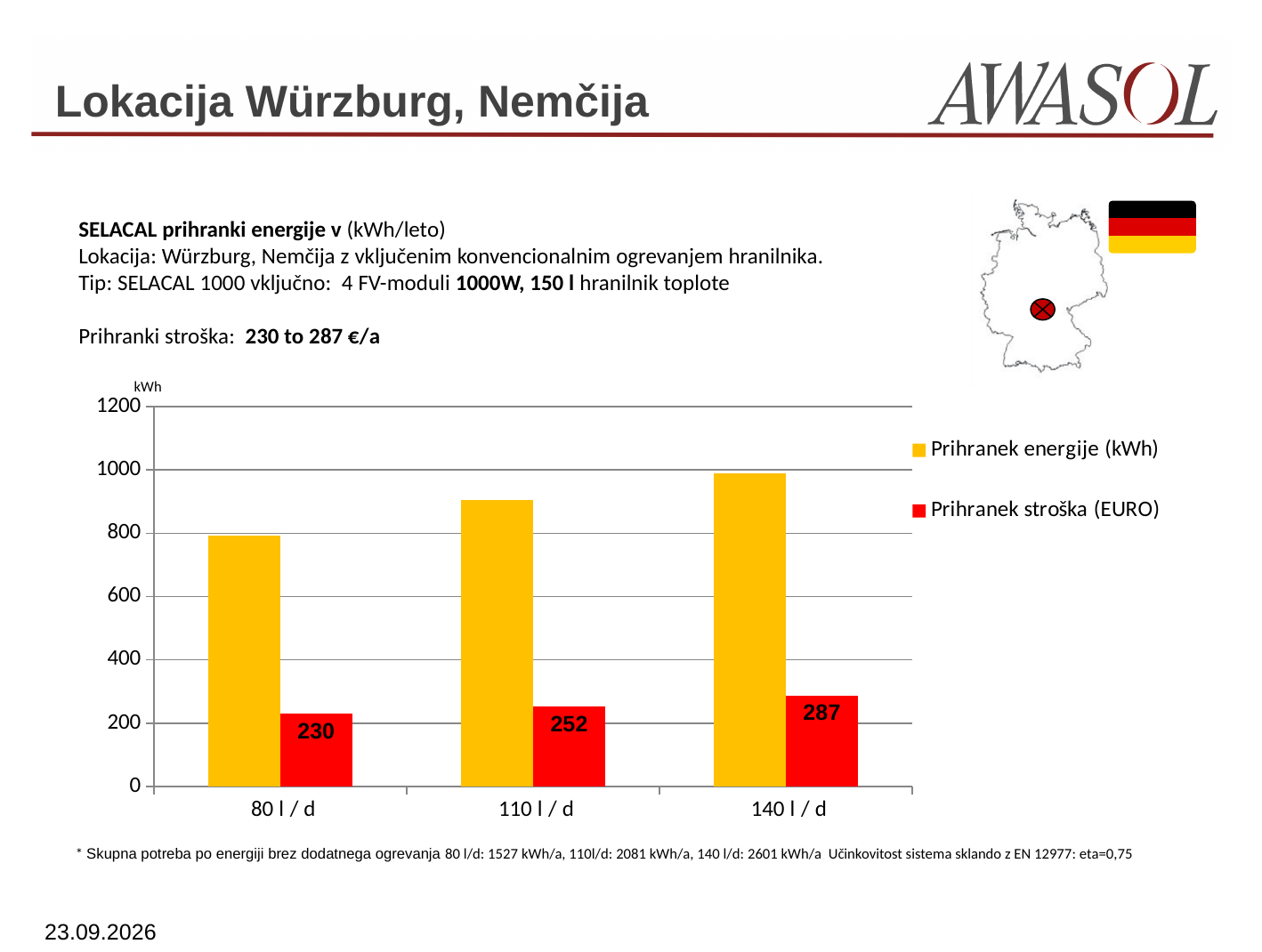
How many series does the chart legend list? 2 Is the Prihranek energije (kWh) value for 110 l / d greater or less than 800? greater What is the difference between the Prihranek stroška (EURO) values for 140 l / d and 80 l / d? 57 What is the Prihranek stroška (EURO) value for 80 l / d? 230 Which category has the larger Prihranek energije (kWh) value, 80 l / d or 140 l / d? 140 l / d Which category has the lowest Prihranek stroška (EURO) value? 80 l / d Which category has the highest Prihranek stroška (EURO) value? 140 l / d What kind of chart is shown on the slide? bar chart What is the Prihranek stroška (EURO) value for 110 l / d? 252 Do the Prihranek energije (kWh) values rise or fall from 80 l / d to 140 l / d? rise What is the Prihranek stroška (EURO) value for 140 l / d? 287 How many categories are shown on the x axis of the chart? 3